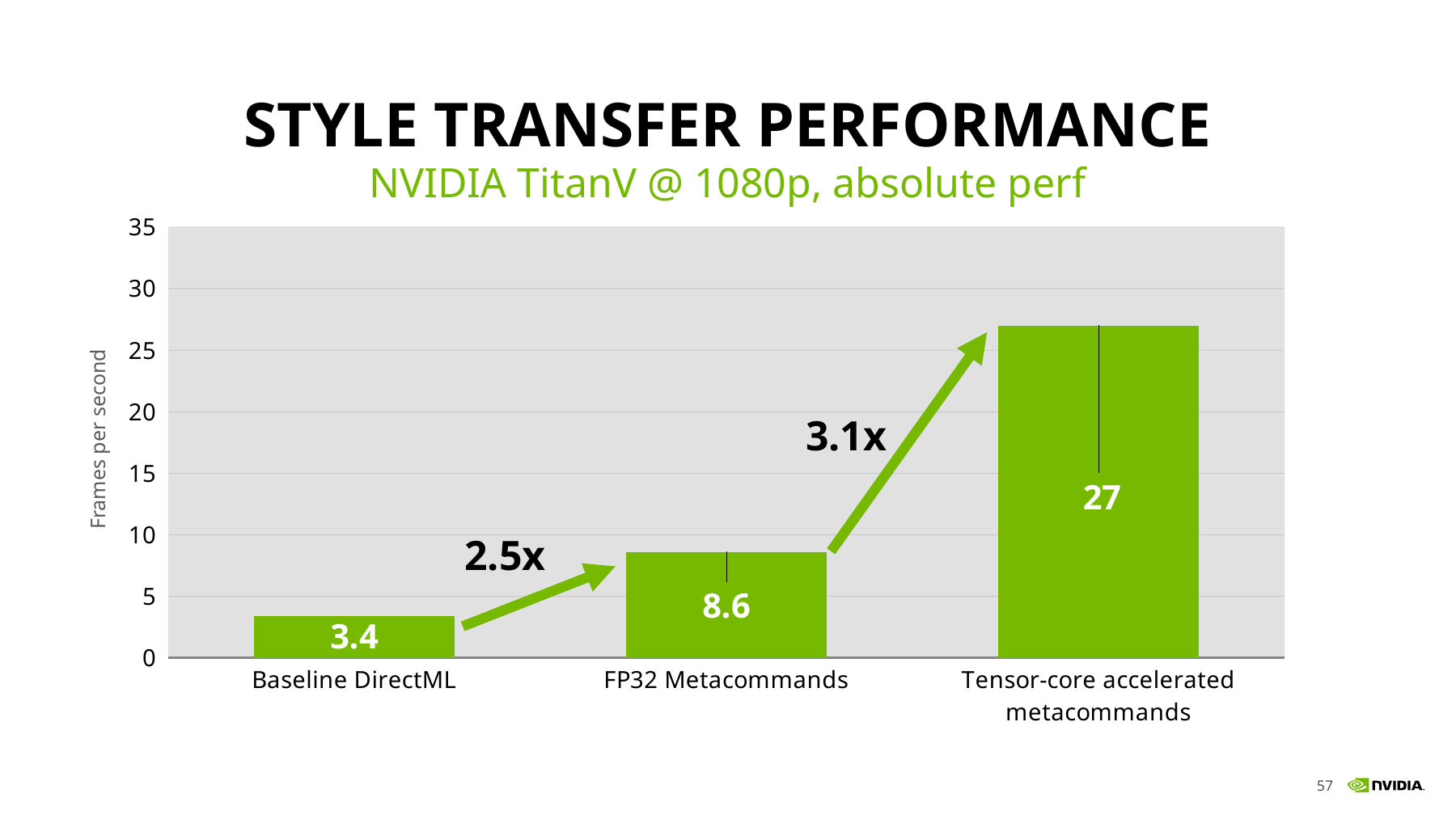
Is the value for Tensor-core accelerated metacommands greater or less than 25? greater Which category has the lowest frames per second? Baseline DirectML What is the frames per second value for Baseline DirectML? 3.4 What speedup factor is labelled on the arrow from FP32 Metacommands to Tensor-core accelerated metacommands? 3.1x What is the difference in frames per second between FP32 Metacommands and Baseline DirectML? 5.2 What kind of chart is shown on the slide? Bar chart How many categories are shown on the x axis? 3 What is the frames per second value for FP32 Metacommands? 8.6 What is the difference in frames per second between Tensor-core accelerated metacommands and FP32 Metacommands? 18.4 Which has a higher frames per second value, Baseline DirectML or FP32 Metacommands? FP32 Metacommands What is the frames per second value for Tensor-core accelerated metacommands? 27 Which category has the highest frames per second? Tensor-core accelerated metacommands